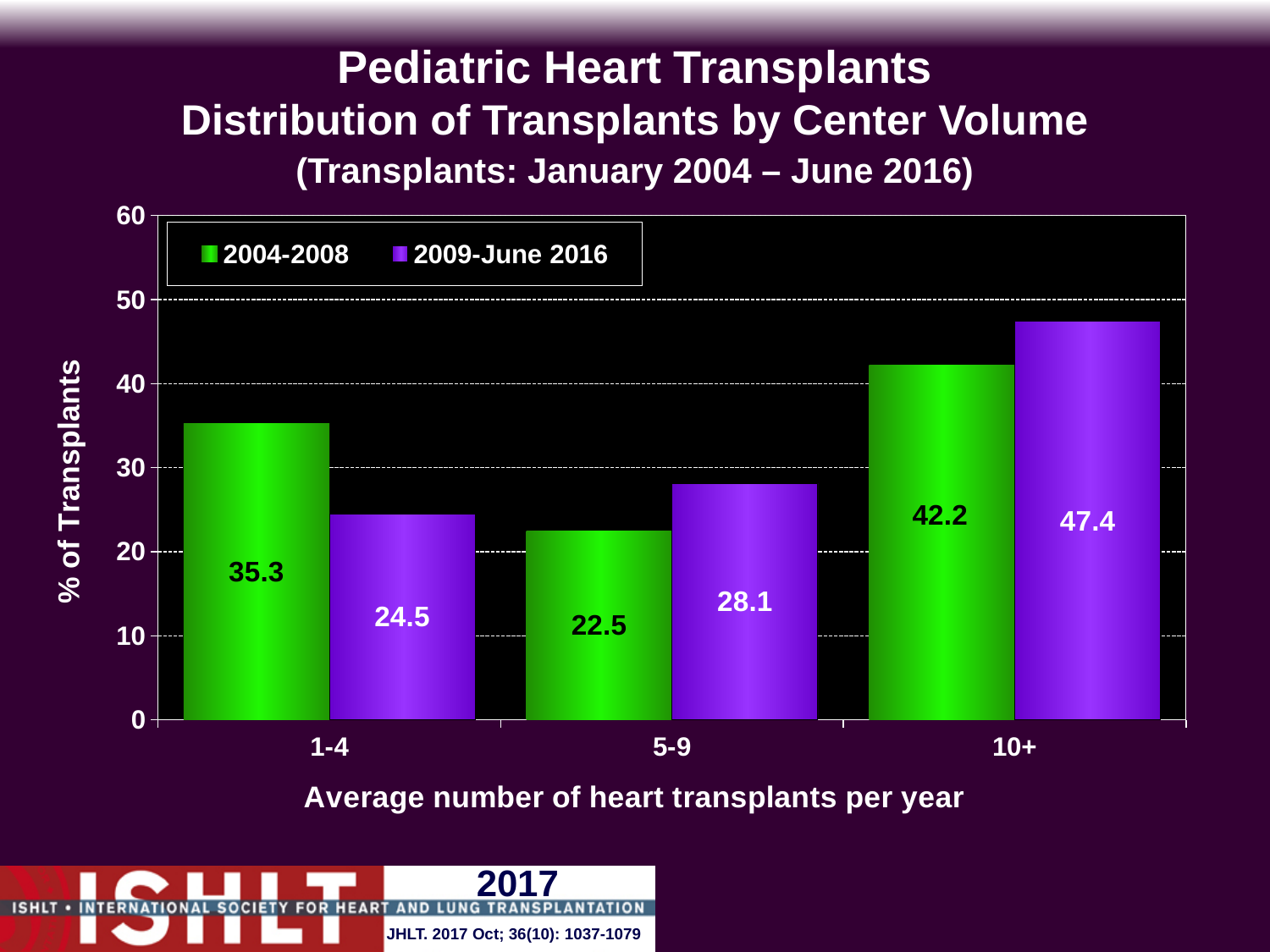
How many series does the legend list? 2 What is the value for the 5-9 category in the 2009-June 2016 series? 28.1 What kind of chart is shown on the slide? bar chart What is the difference between the 2009-June 2016 and 2004-2008 values for the 10+ category? 5.2 What is the value for the 10+ category in the 2009-June 2016 series? 47.4 Is the value for the 5-9 category in the 2004-2008 series greater or less than 30? less What is the value for the 1-4 category in the 2004-2008 series? 35.3 For the 1-4 category, which series has the larger value, 2004-2008 or 2009-June 2016? 2004-2008 How many categories are shown on the x axis? 3 What is the label of the y axis? % of Transplants Which category has the highest value in the 2004-2008 series? 10+ Which category has the lowest value in the 2009-June 2016 series? 1-4